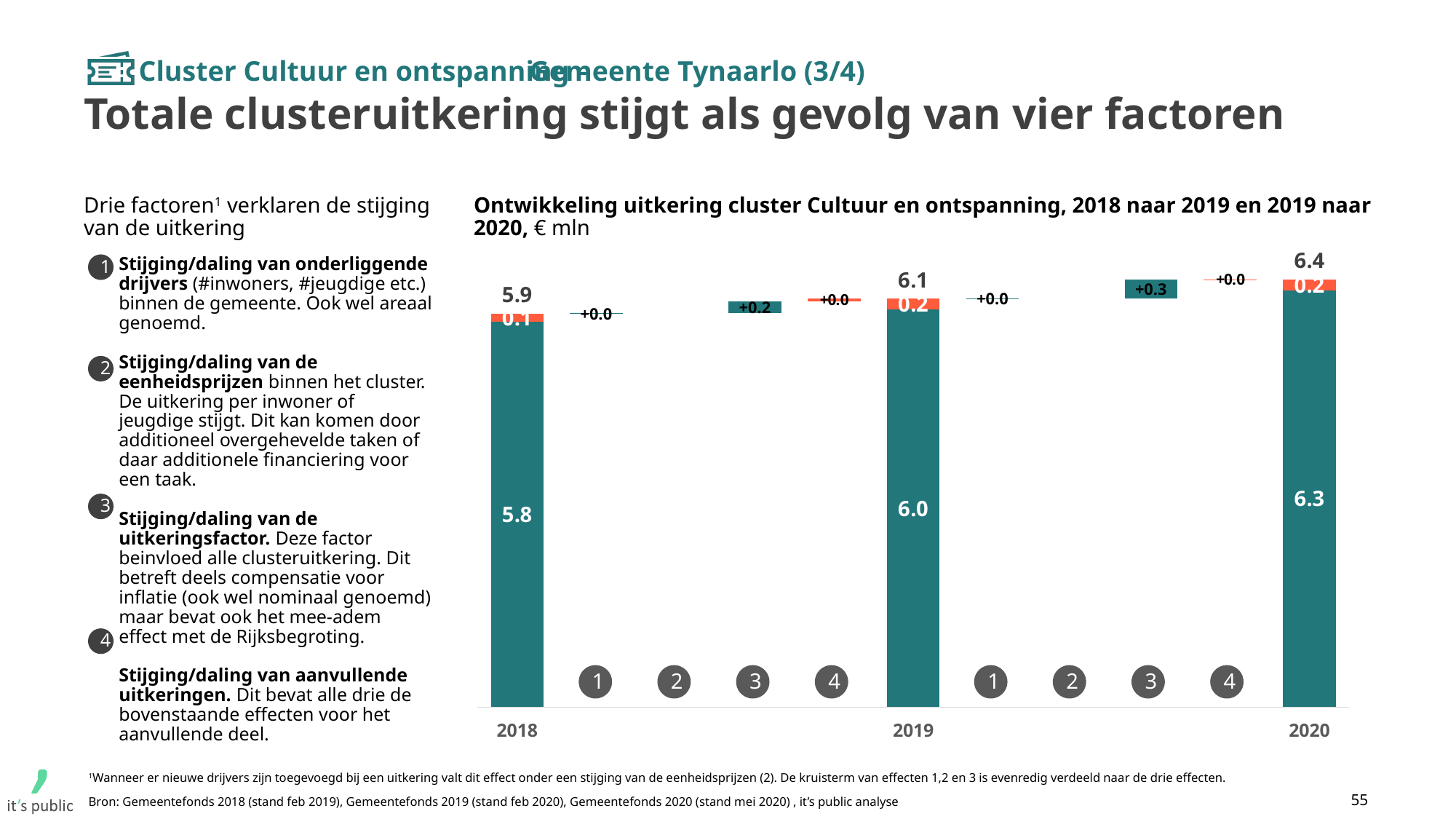
Which year has the highest total uitkering? 2020 What is the difference between the 2020 total and the 2018 total? 0.5 Do the total values rise or fall from 2018 to 2020? rise Which year has the lowest total uitkering? 2018 What is the value of the large teal segment of the 2020 bar? 6.3 What is the effect of factor 3 between 2019 and 2020? +0.3 In what unit are the values on the chart expressed? € mln What is the total uitkering for 2020 shown on the chart? 6.4 What is the total uitkering for 2019 shown on the chart? 6.1 What is the total uitkering for 2018 shown on the chart? 5.9 What is the value of the orange segment of the 2018 bar? 0.1